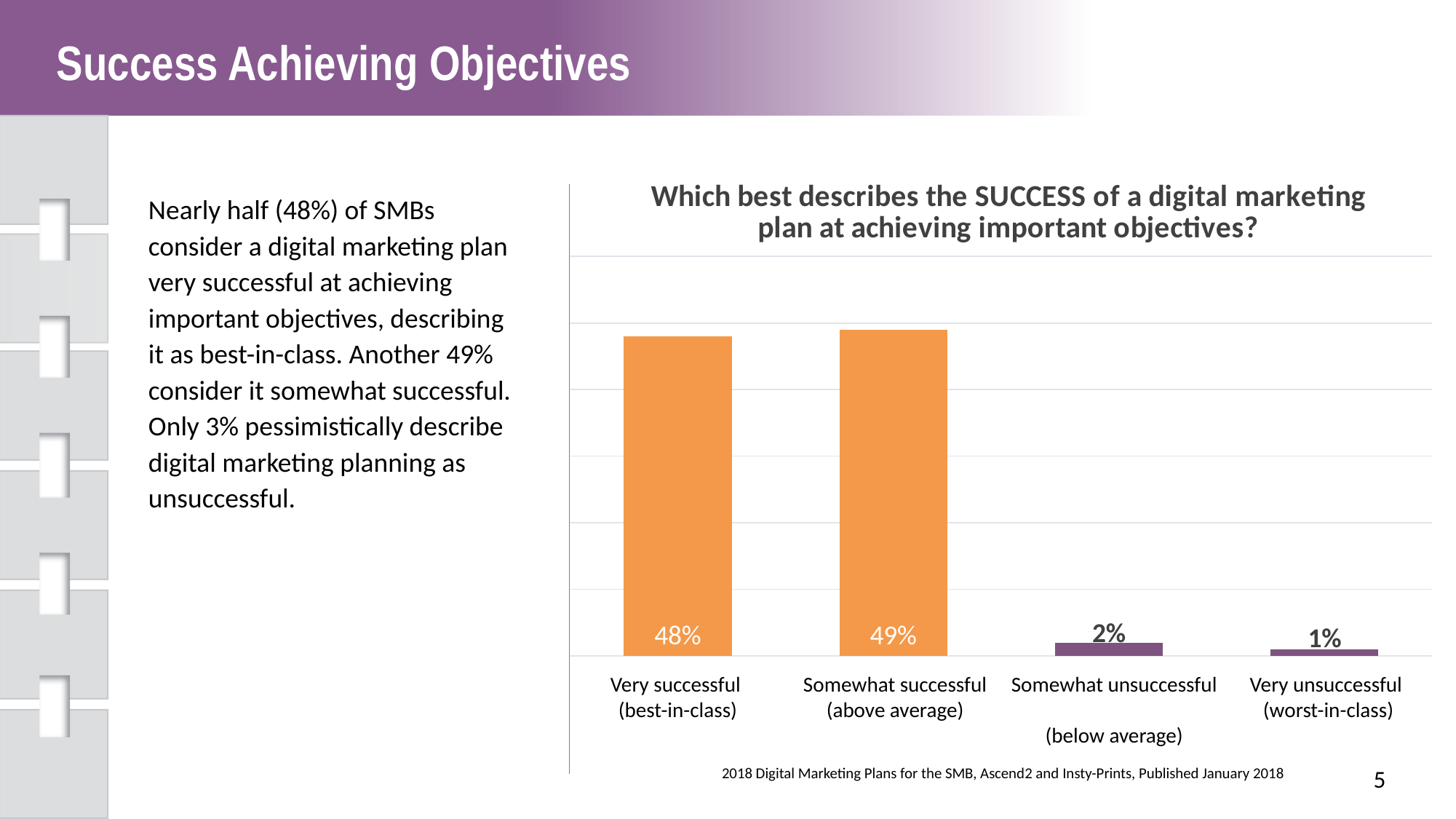
What is the value for Very unsuccessful (worst-in-class)? 1% What is the value for Somewhat unsuccessful (below average)? 2% Which category has the highest value? Somewhat successful (above average) What kind of chart is shown on the slide? Bar chart What is the value for Somewhat successful (above average)? 49% How many categories are shown in the chart? 4 Which category has the lowest value? Very unsuccessful (worst-in-class) What is the difference between the Very successful and Somewhat unsuccessful values? 46% Which is larger: the value for Somewhat unsuccessful or Very unsuccessful? Somewhat unsuccessful What is the difference between the Somewhat successful and Very successful values? 1% What percentage of respondents describe a digital marketing plan as very successful (best-in-class)? 48% What colour are the bars for the two unsuccessful categories? Purple